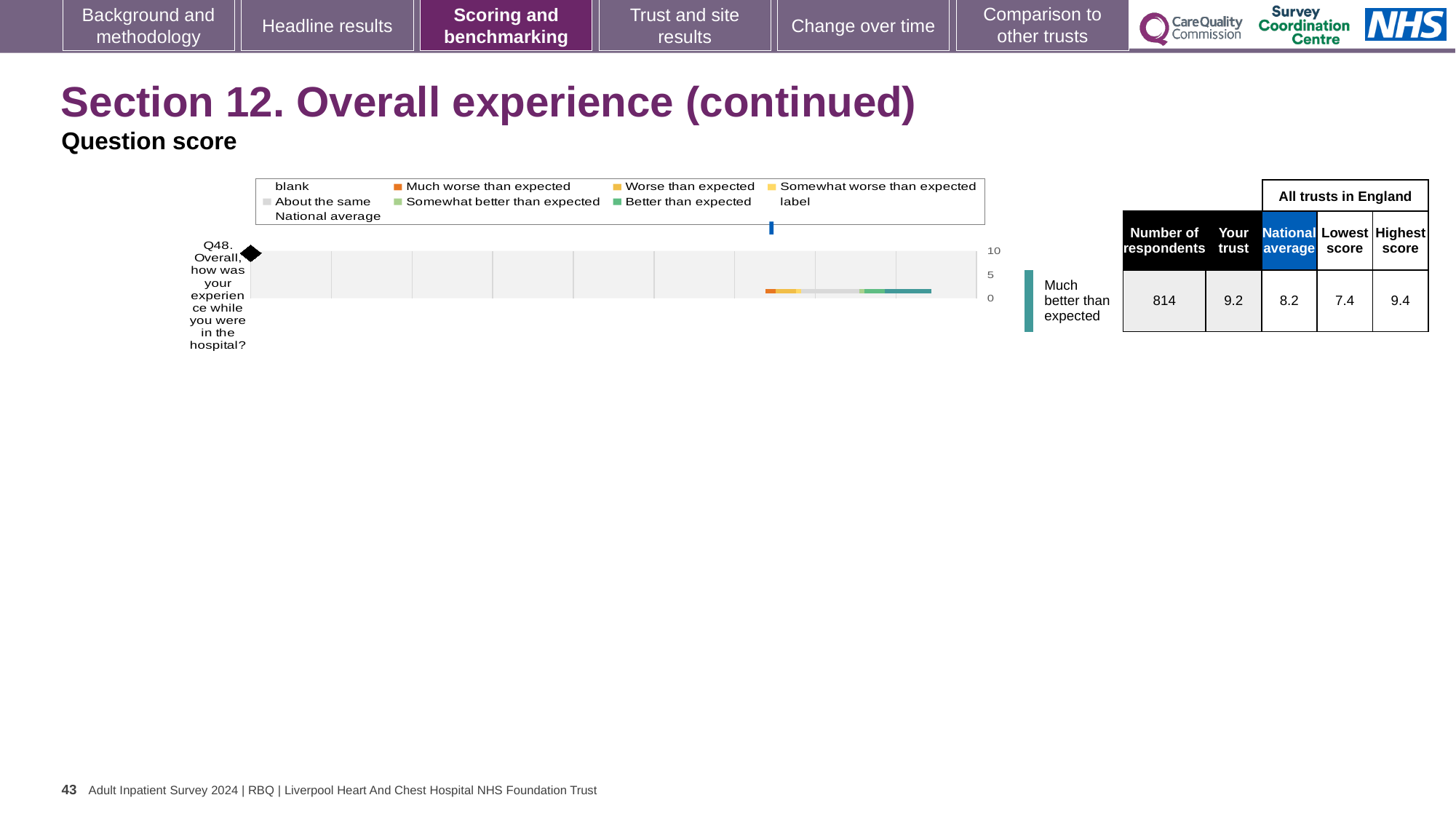
What is the highest value shown on the chart's score axis? 10 How many respondents answered Q48? 814 What is the highest score among all trusts in England for Q48? 9.4 Which benchmark category is the trust's Q48 score assigned to? Much better than expected How many questions (categories) are plotted in the chart? 1 What is the national average score for Q48 in the table next to the chart? 8.2 What is the 'Your trust' score for Q48 in the table next to the chart? 9.2 What is the difference between the 'Your trust' score and the national average for Q48? 1.0 What kind of chart is shown on the slide? bar chart Is the 'Your trust' score for Q48 higher or lower than the national average? higher What is the lowest score among all trusts in England for Q48? 7.4 Which question is plotted in the chart? Q48. Overall, how was your experience while you were in the hospital?